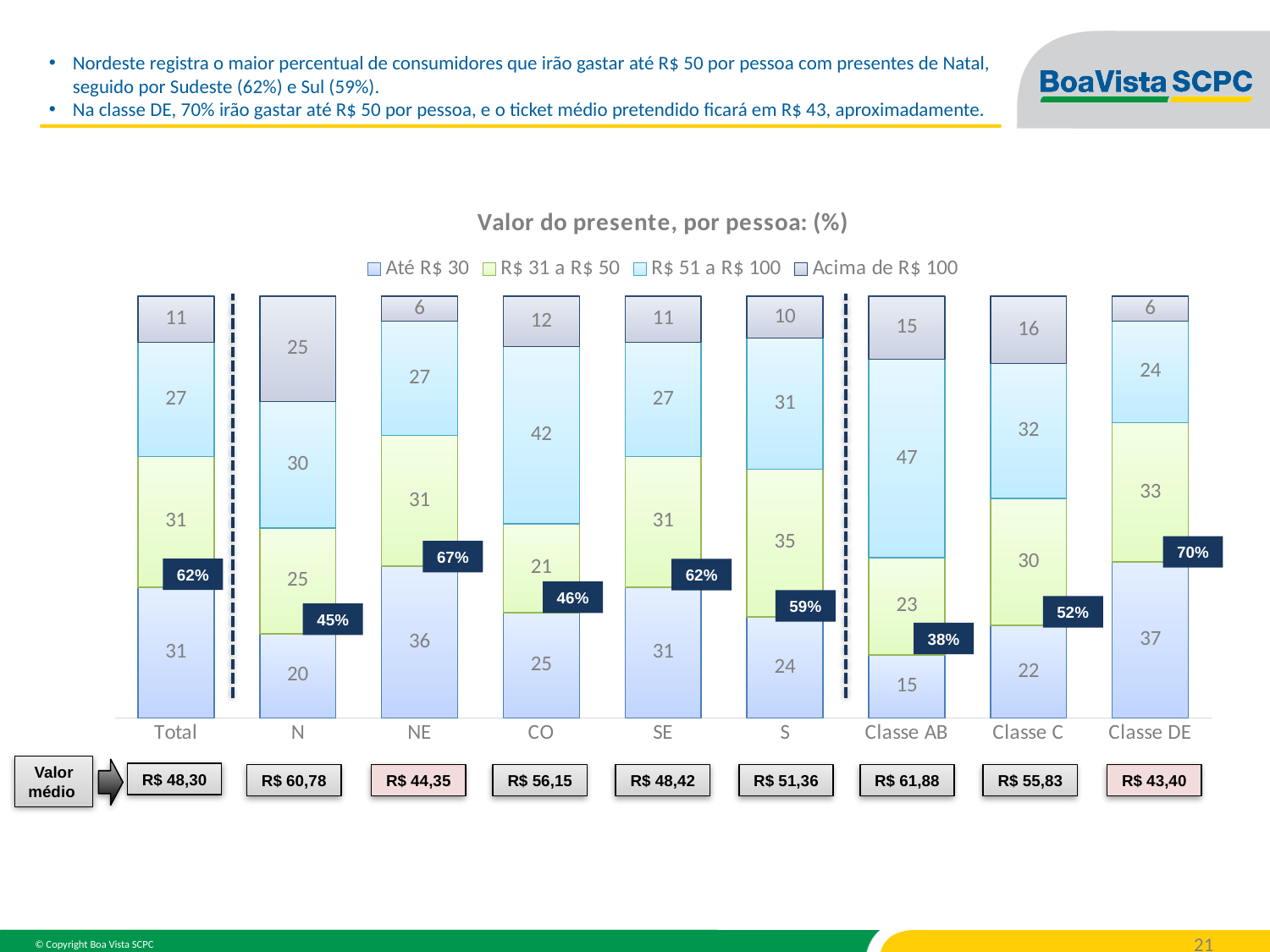
What is the title of the chart? Valor do presente, por pessoa: (%) What is the value of the 'R$ 51 a R$ 100' segment for Classe AB? 47 What is the value of the 'Até R$ 30' segment for NE? 36 How many categories are shown along the x axis of the chart? 9 Which category has the lowest 'Até R$ 30' value? Classe AB What is the value of the 'Acima de R$ 100' segment for N? 25 Which category has the highest 'Até R$ 30' value? Classe DE How many series does the chart legend list? 4 What kind of chart is shown on the slide? Stacked bar chart What is the difference between the 'R$ 51 a R$ 100' values for CO and SE? 15 Which is larger, the 'R$ 31 a R$ 50' value for S or for Classe C? S What is the 'Valor médio' shown for Classe DE? R$ 43,40